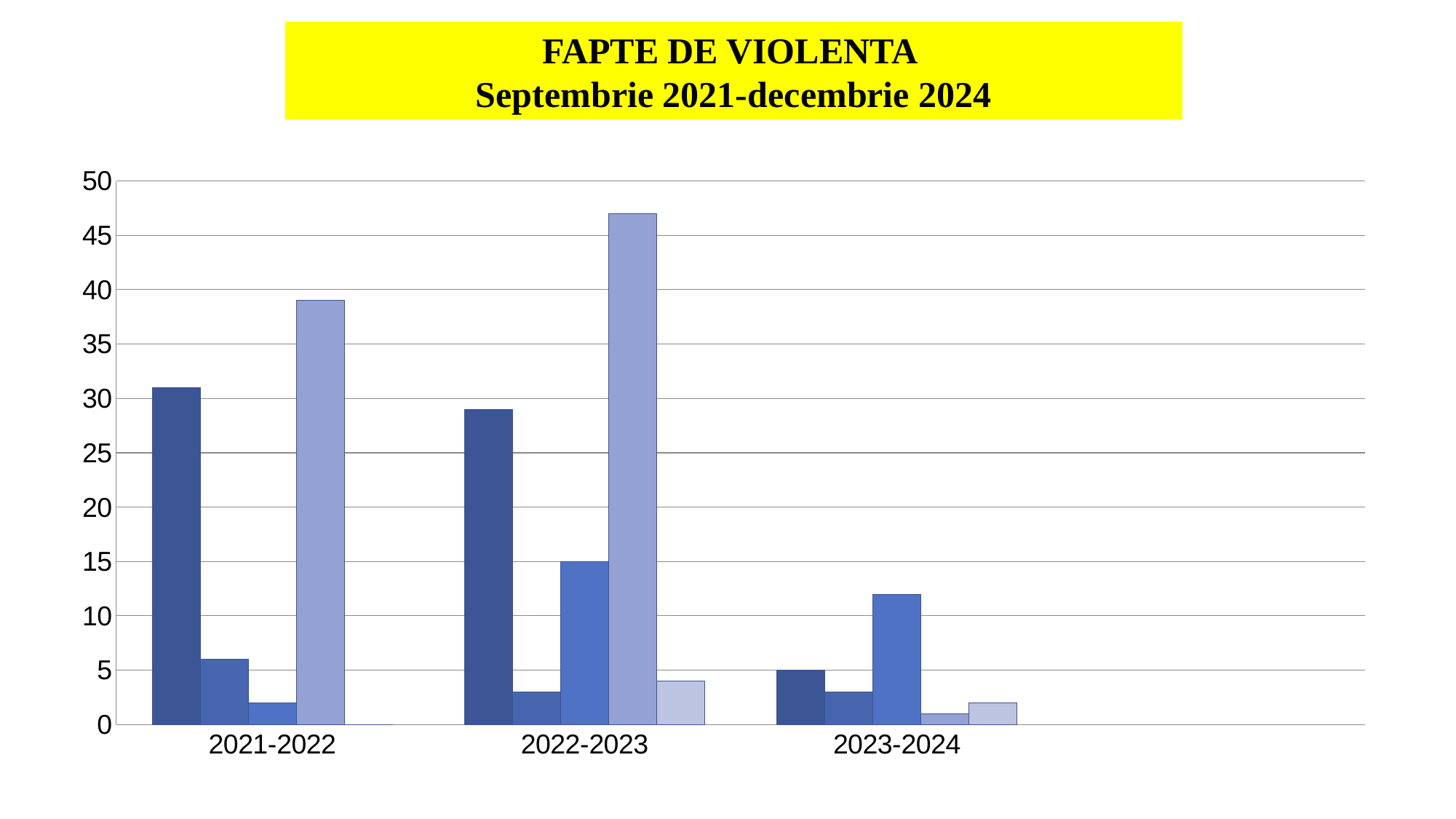
Is the darkest (first) bar in the 2021-2022 group greater or less than 25? greater How many bars are plotted in the 2021-2022 group? 4 What kind of chart is shown on the slide? bar chart How many bars are plotted in the 2023-2024 group? 5 Is the tallest bar in the 2021-2022 group greater or less than 35? greater What is the title shown above the chart? FAPTE DE VIOLENTA Septembrie 2021-decembrie 2024 Is the tallest bar in the 2023-2024 group greater or less than 15? less How many categories are shown on the x axis of the chart? 3 Which category contains the tallest bar in the whole chart? 2022-2023 Which category has the shorter tallest bar: 2021-2022 or 2023-2024? 2023-2024